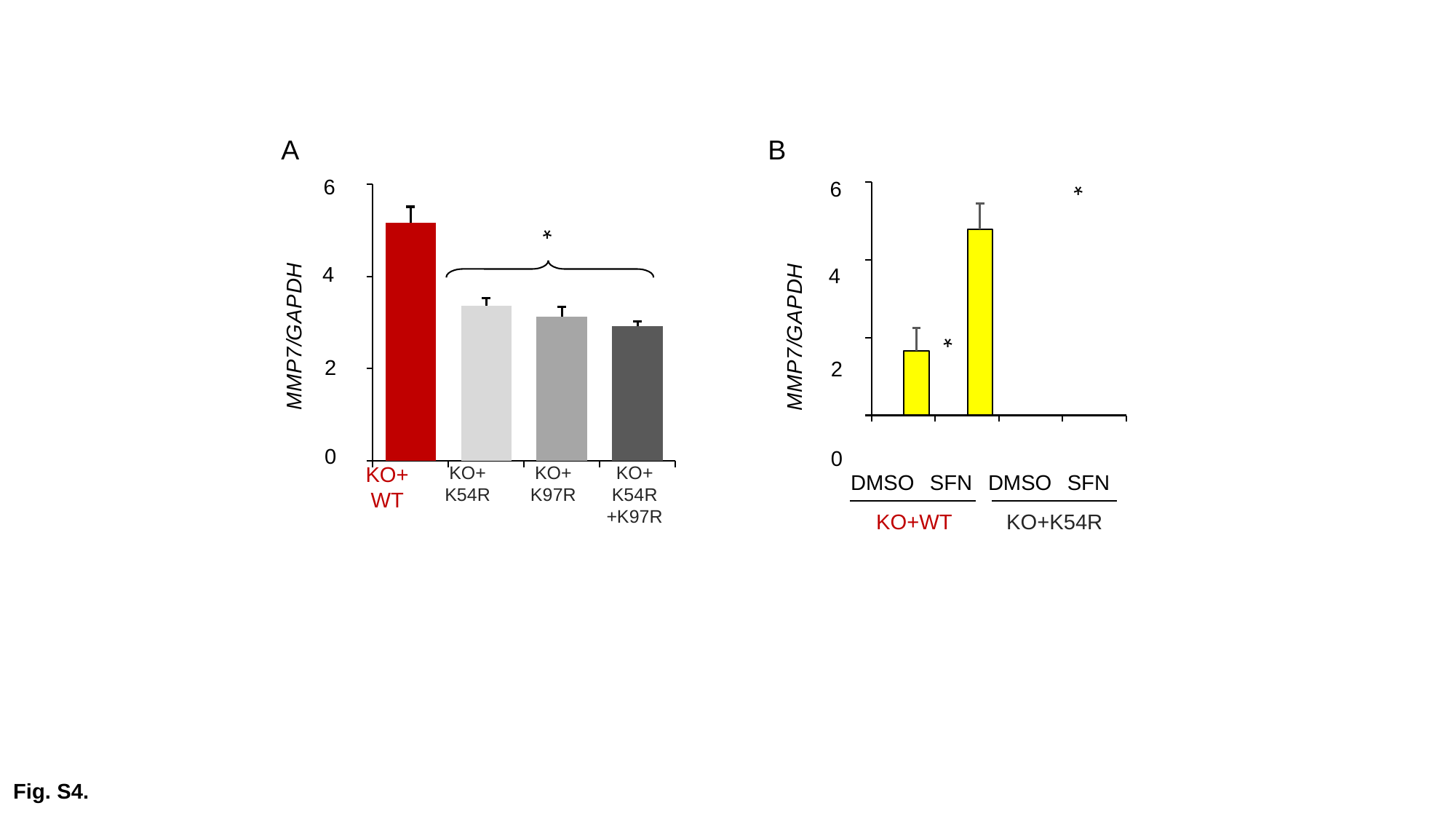
In chart A, what is the y-axis label? MMP7/GAPDH In chart B, is the value for KO+WT DMSO greater or less than 4? less In chart B, which condition has the highest MMP7/GAPDH value? KO+WT SFN In chart A, do the bar values rise or fall from left to right? fall In chart B, which is larger, the value for KO+WT DMSO or the value for KO+WT SFN? KO+WT SFN In chart A, how many bars are plotted? 4 In chart A, which category has the highest MMP7/GAPDH value? KO+WT In chart A, what kind of chart is shown? bar chart In chart A, which is larger, the value for KO+WT or the value for KO+K97R? KO+WT In chart A, is the value for KO+WT greater or less than 4? greater In chart A, is the value for KO+K54R+K97R greater or less than 4? less